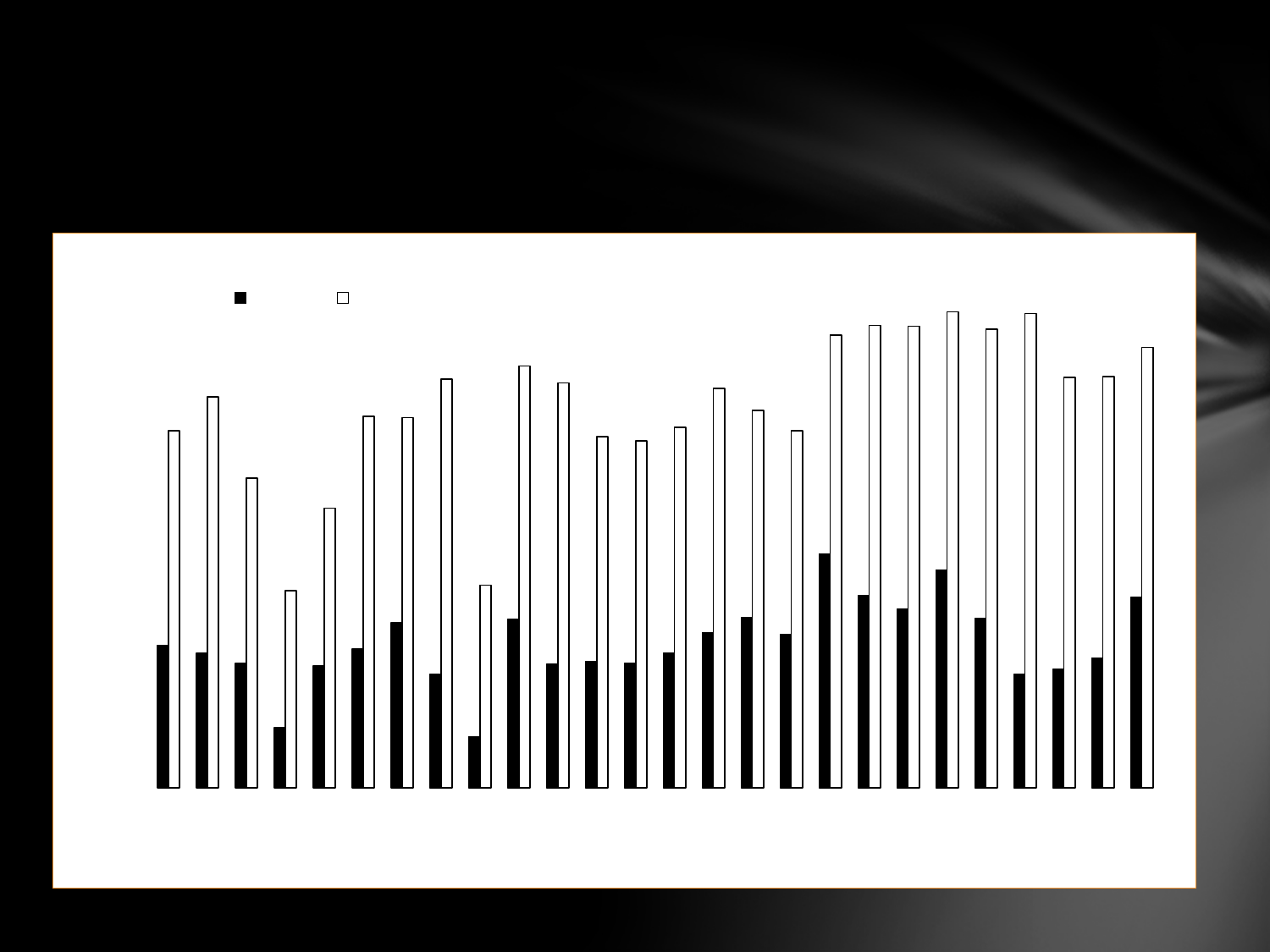
What kind of chart is shown on the slide? bar chart Are the bars in the chart vertical or horizontal? vertical How many series does the legend list? 2 Which series has the taller bars in every category, the black series or the white series? the white series What two colours are used for the bars in the chart? black and white How many categories (pairs of bars) are plotted in the chart? 26